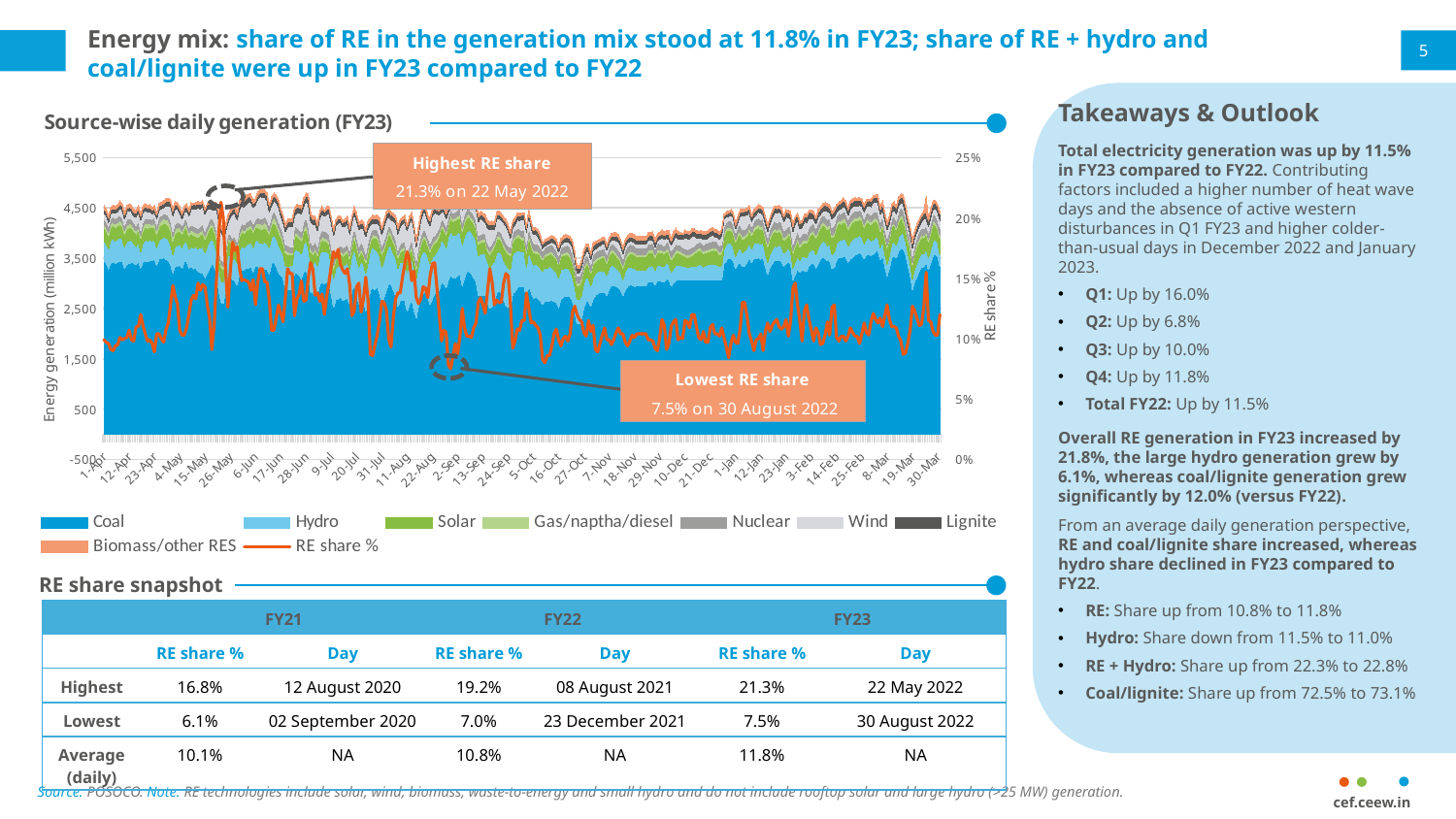
What is the lowest RE share value annotated on the chart? 7.5% Is the lowest RE share annotated on the chart greater or less than 10%? less What is the difference in percentage points between the highest and lowest RE share annotated on the chart? 13.8 percentage points What is the label of the right-hand vertical axis of the chart? RE share % What is the highest RE share value annotated on the Source-wise daily generation (FY23) chart? 21.3% On which date did the lowest RE share occur according to the chart annotation? 30 August 2022 Which source accounts for the largest area in the stacked generation chart? Coal On which date did the highest RE share occur according to the chart annotation? 22 May 2022 Is the highest RE share annotated on the chart greater or less than 20%? greater How many series does the legend of the Source-wise daily generation chart list? 9 What is the title of the chart on the slide? Source-wise daily generation (FY23) What kind of chart is the Source-wise daily generation (FY23) chart? Stacked area chart with a line